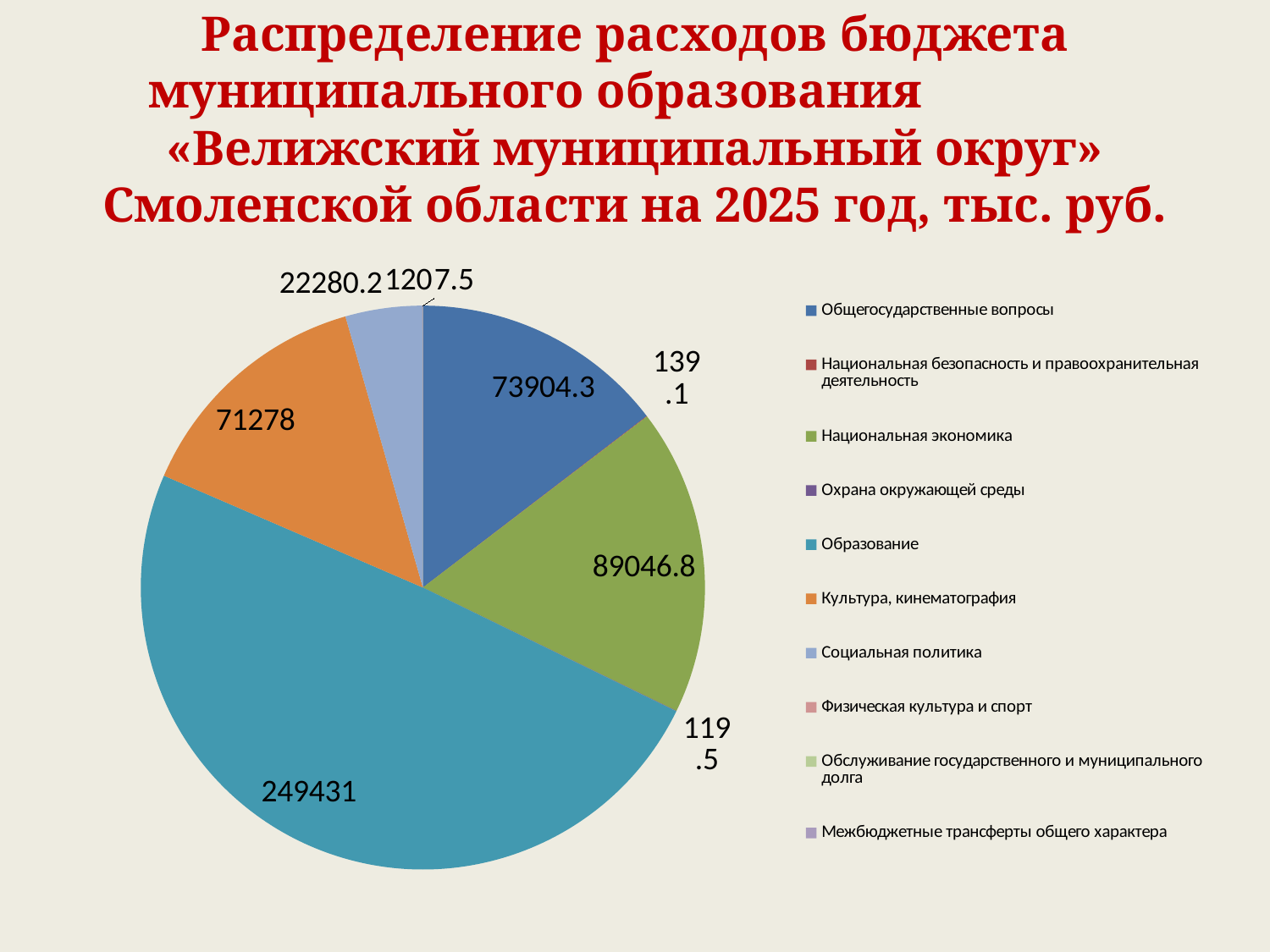
What kind of chart is shown on the slide? pie chart What is the value for Общегосударственные вопросы? 73904.3 What is the difference between the values for Образование and Культура, кинематография? 178153 Which category has the largest slice of the pie? Образование Which is larger, the value for Образование or the value for Социальная политика? Образование What is the value for Национальная экономика? 89046.8 How many entries does the legend list? 10 What is the difference between the values for Национальная экономика and Общегосударственные вопросы? 15142.5 In what units are the values on the chart given, according to the title? тыс. руб. What is the value for Образование? 249431 What is the value for Социальная политика? 22280.2 What is the value for Культура, кинематография? 71278